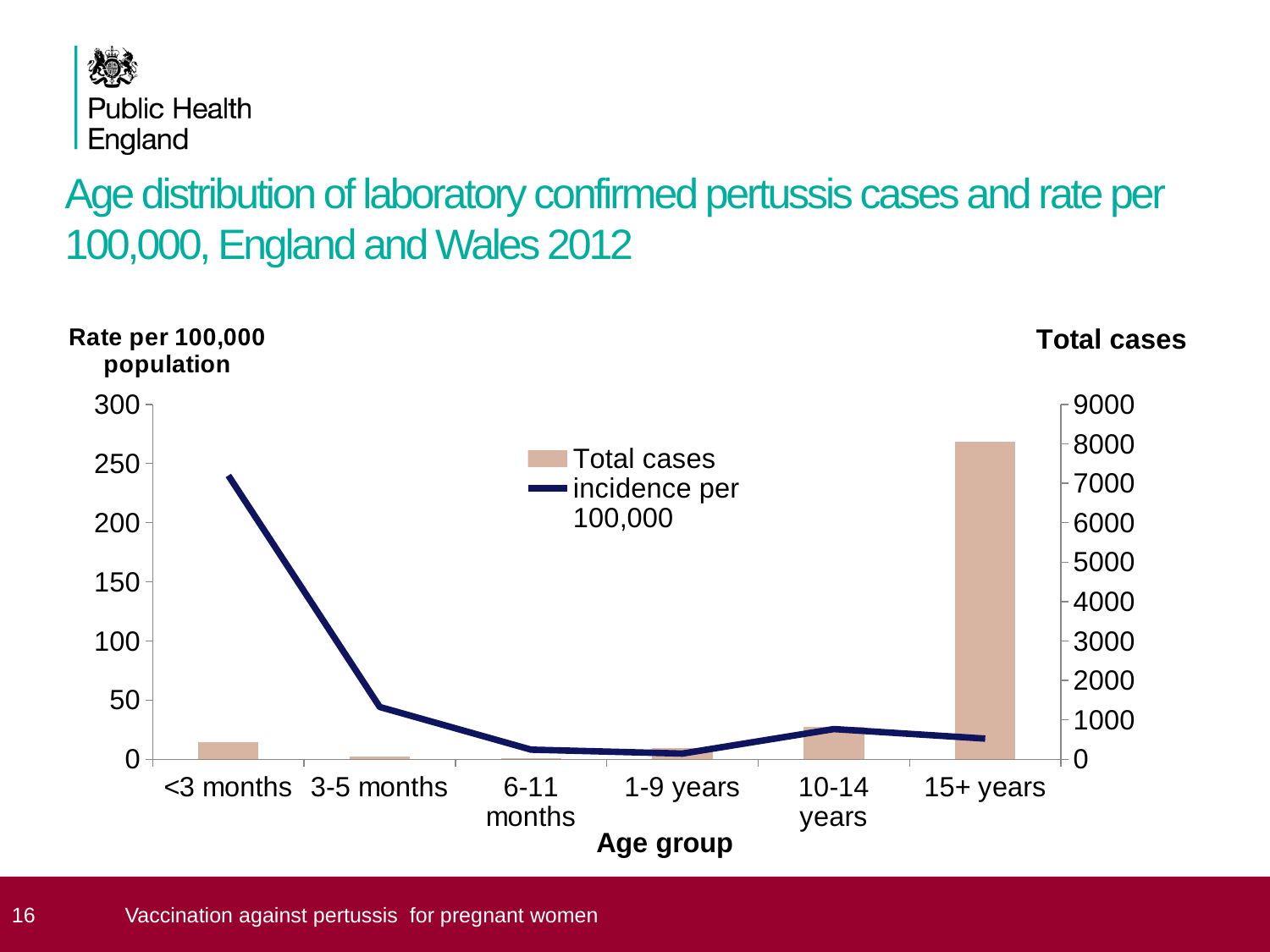
How many age groups are shown on the x axis? 6 Which age group has the highest incidence per 100,000? <3 months Is the number of total cases for <3 months greater or less than 1000? less What kind of chart is shown on the slide? A combined bar and line chart Is the incidence per 100,000 for 3-5 months greater or less than 100? less How many series does the legend list? 2 What is the label of the right-hand vertical axis? Total cases Does the incidence per 100,000 rise or fall from <3 months to 1-9 years? fall Which has the higher incidence per 100,000: <3 months or 3-5 months? <3 months Which age group has the highest number of total cases? 15+ years Is the number of total cases for 15+ years greater or less than 7000? greater